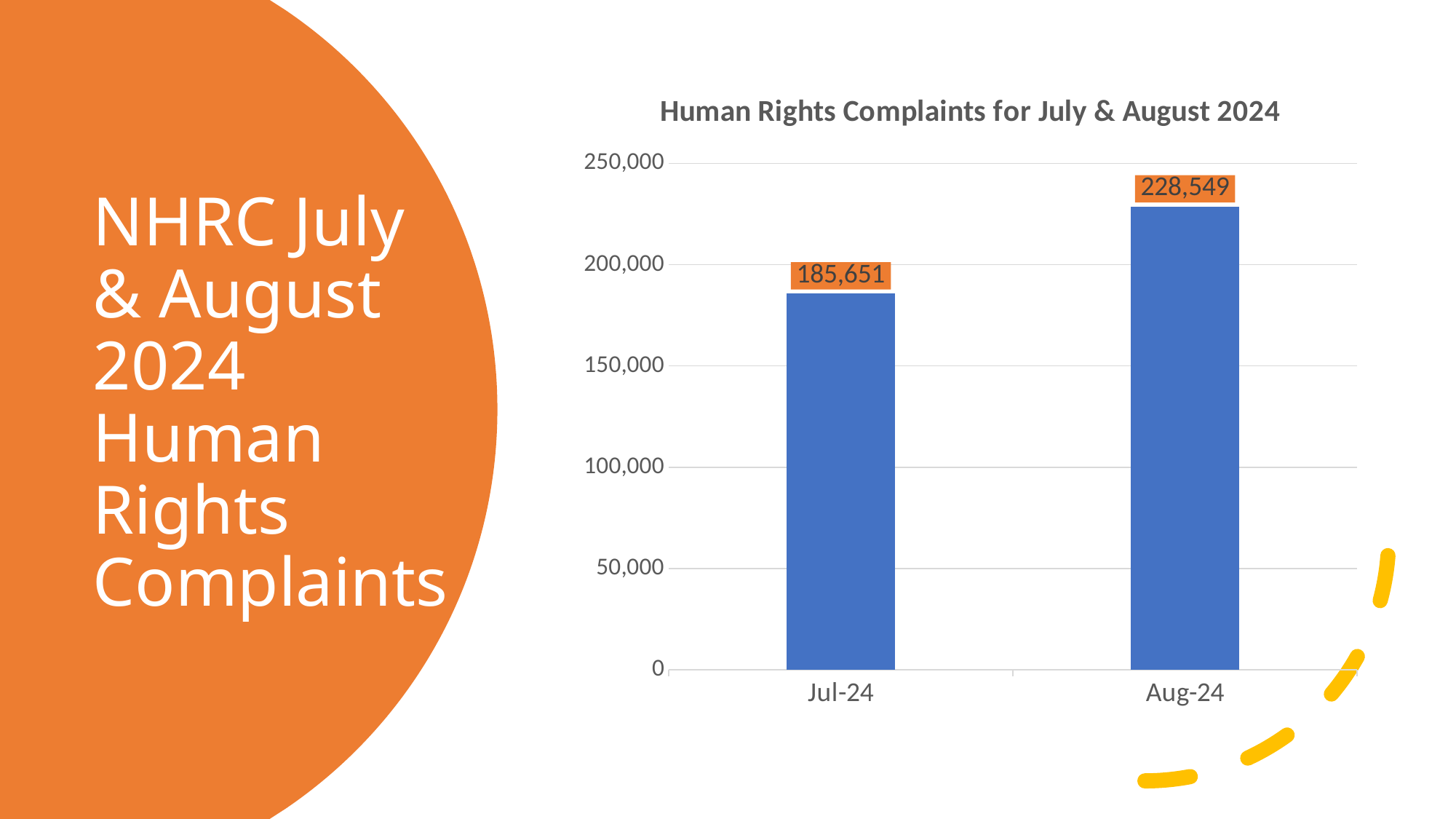
What is the value for Aug-24? 228,549 What is the value for Jul-24? 185,651 Which month has the highest number of complaints? Aug-24 Is the value for Aug-24 greater or less than 200,000? greater How many categories are shown on the x axis? 2 Do the values rise or fall from Jul-24 to Aug-24? rise What is the title of the chart? Human Rights Complaints for July & August 2024 Which is larger, the value for Jul-24 or the value for Aug-24? Aug-24 What kind of chart is shown? bar chart Which month has the lowest number of complaints? Jul-24 Is the value for Jul-24 greater or less than 200,000? less What is the difference between the Aug-24 and Jul-24 values? 42,898